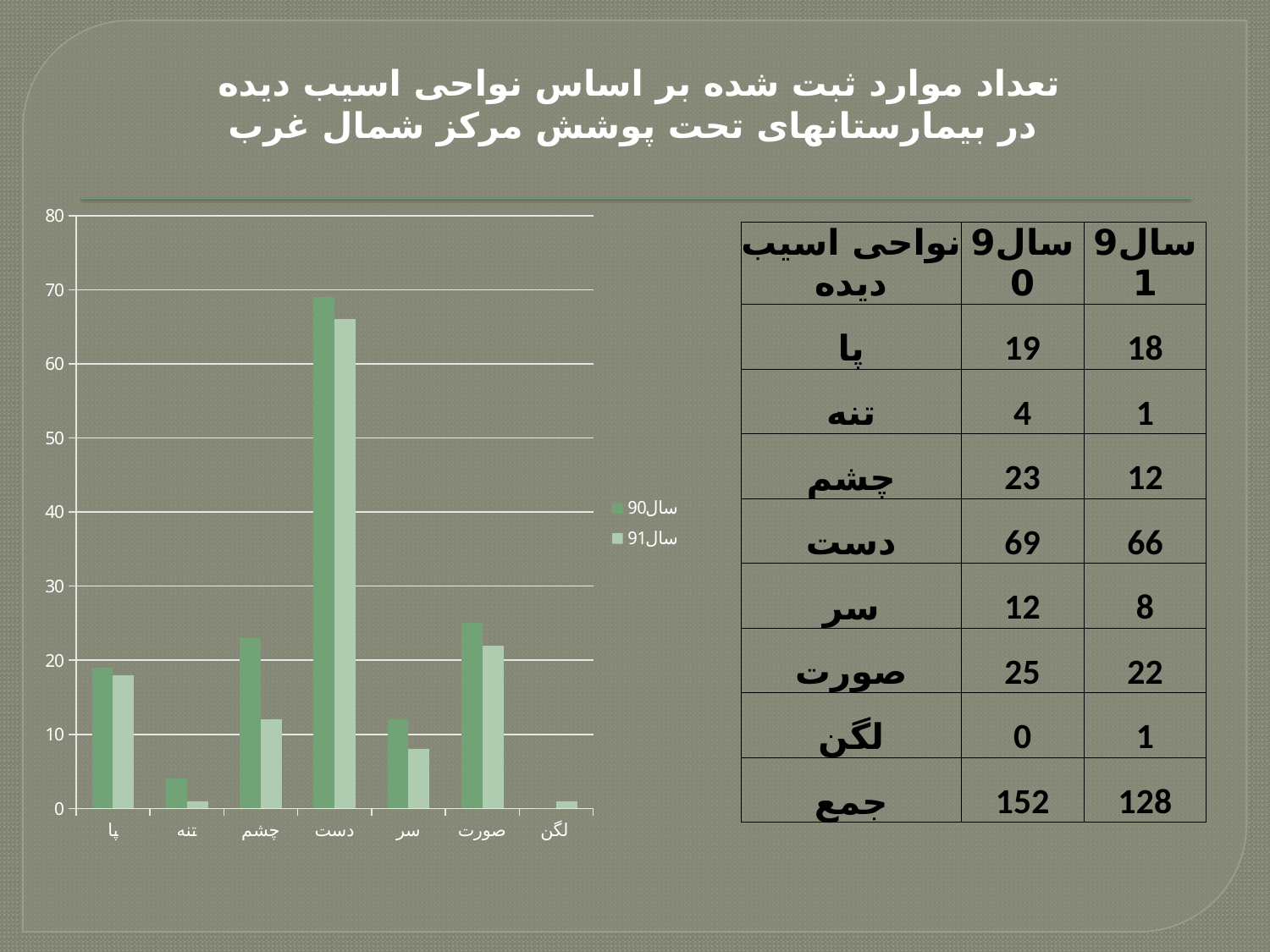
What is the value for چشم in سال90? 23 Is the value for سر in سال91 greater or less than 10? less What kind of chart is shown on the slide? bar chart Which category has the highest value for سال90? دست How many categories are shown on the x axis of the chart? 7 How many series does the chart legend list? 2 Which category has the lowest value for سال90? لگن Which is larger for صورت: the سال90 value or the سال91 value? سال90 What is the value for دست in سال91? 66 What is the difference between the سال90 and سال91 values for چشم? 11 What are the two legend entries of the chart? سال90 and سال91 Is the value for دست in سال90 greater or less than 60? greater